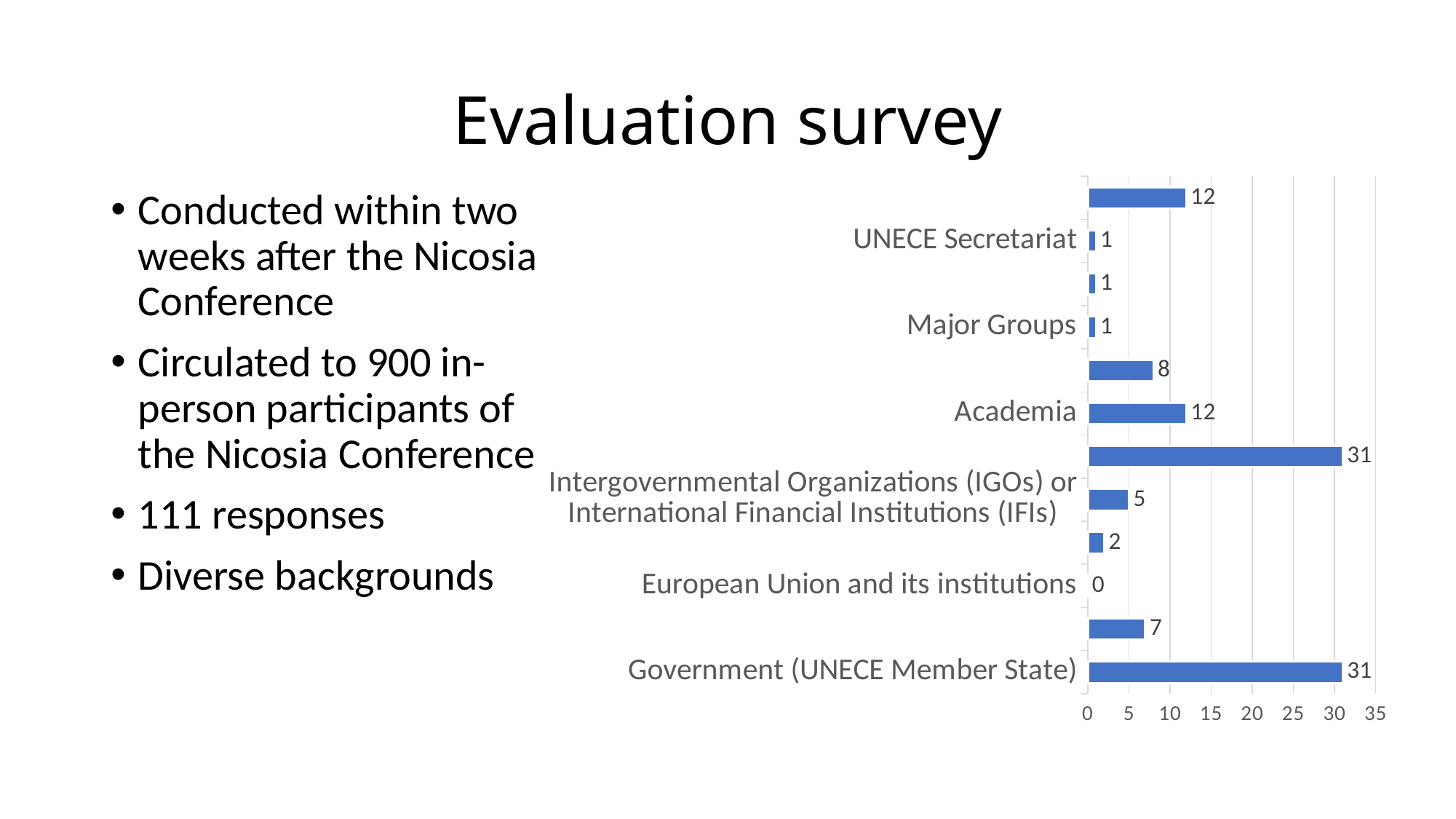
Which is larger, the value for Academia or the value for Intergovernmental Organizations (IGOs) or International Financial Institutions (IFIs)? Academia What is the value for European Union and its institutions? 0 What is the difference between the values for Government (UNECE Member State) and Academia? 19 What is the value for Intergovernmental Organizations (IGOs) or International Financial Institutions (IFIs)? 5 Which labelled category has the lowest value? European Union and its institutions How many bars are plotted in the chart? 12 What is the value for Academia? 12 What is the highest value shown on the horizontal axis? 35 What is the value for Government (UNECE Member State)? 31 What is the value for UNECE Secretariat? 1 What is the value for Major Groups? 1 What kind of chart is shown on the slide? bar chart